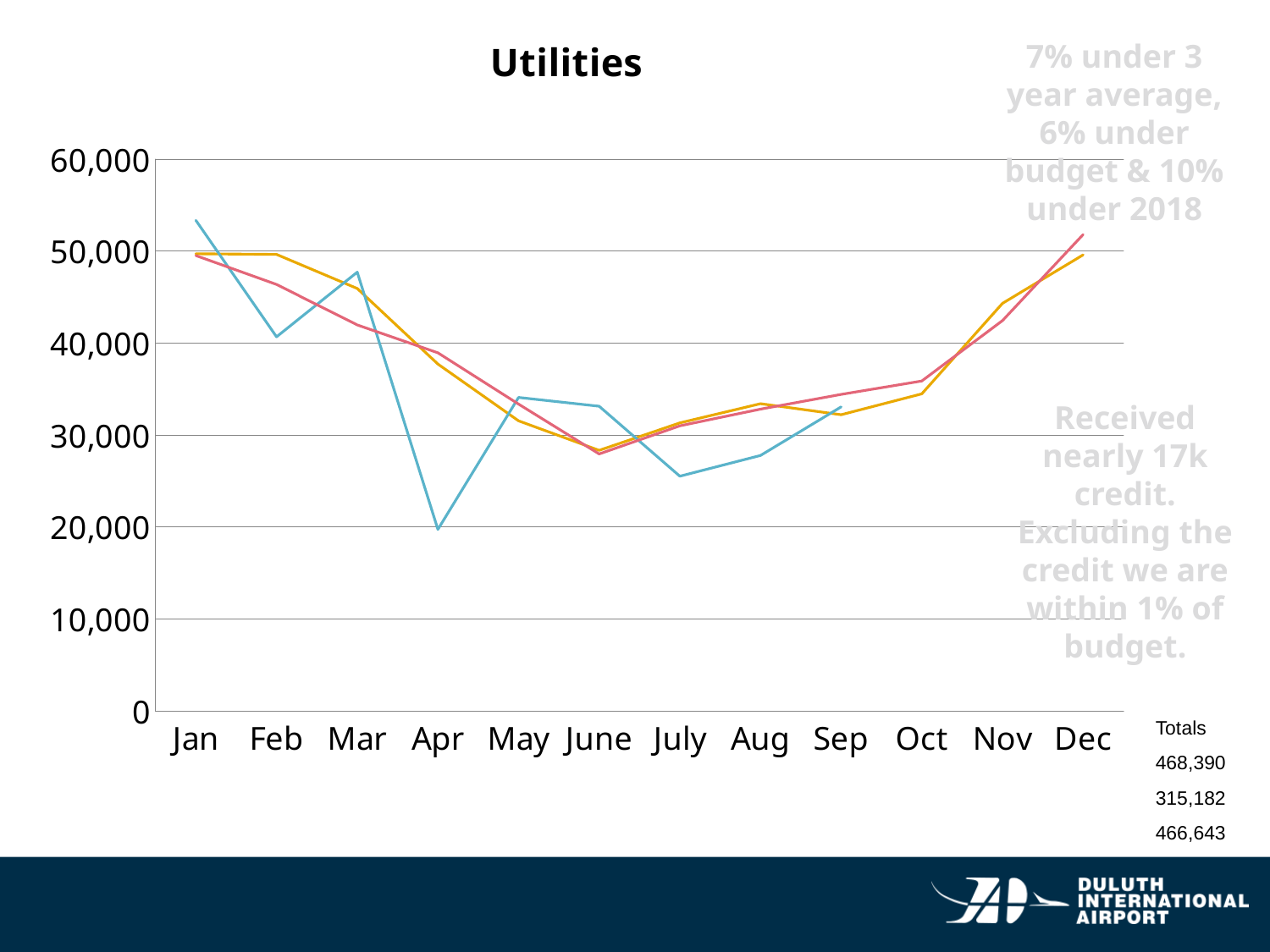
In which month does the pink line reach its lowest value? June Does the pink line rise or fall from Jan to June? fall How many lines are plotted on the chart? 3 How many months are shown along the x axis of the chart? 12 What kind of chart is shown on the slide? line chart What is the title of the chart? Utilities In which month does the blue line reach its lowest value? Apr Is the value of the blue line in Apr greater or less than 30,000? less Is the value of the blue line in Jan greater or less than 50,000? greater In which month does the blue line reach its highest value? Jan In Apr, which line has the higher value, the blue line or the pink line? the pink line Is the value of the orange line in Nov greater or less than 40,000? greater